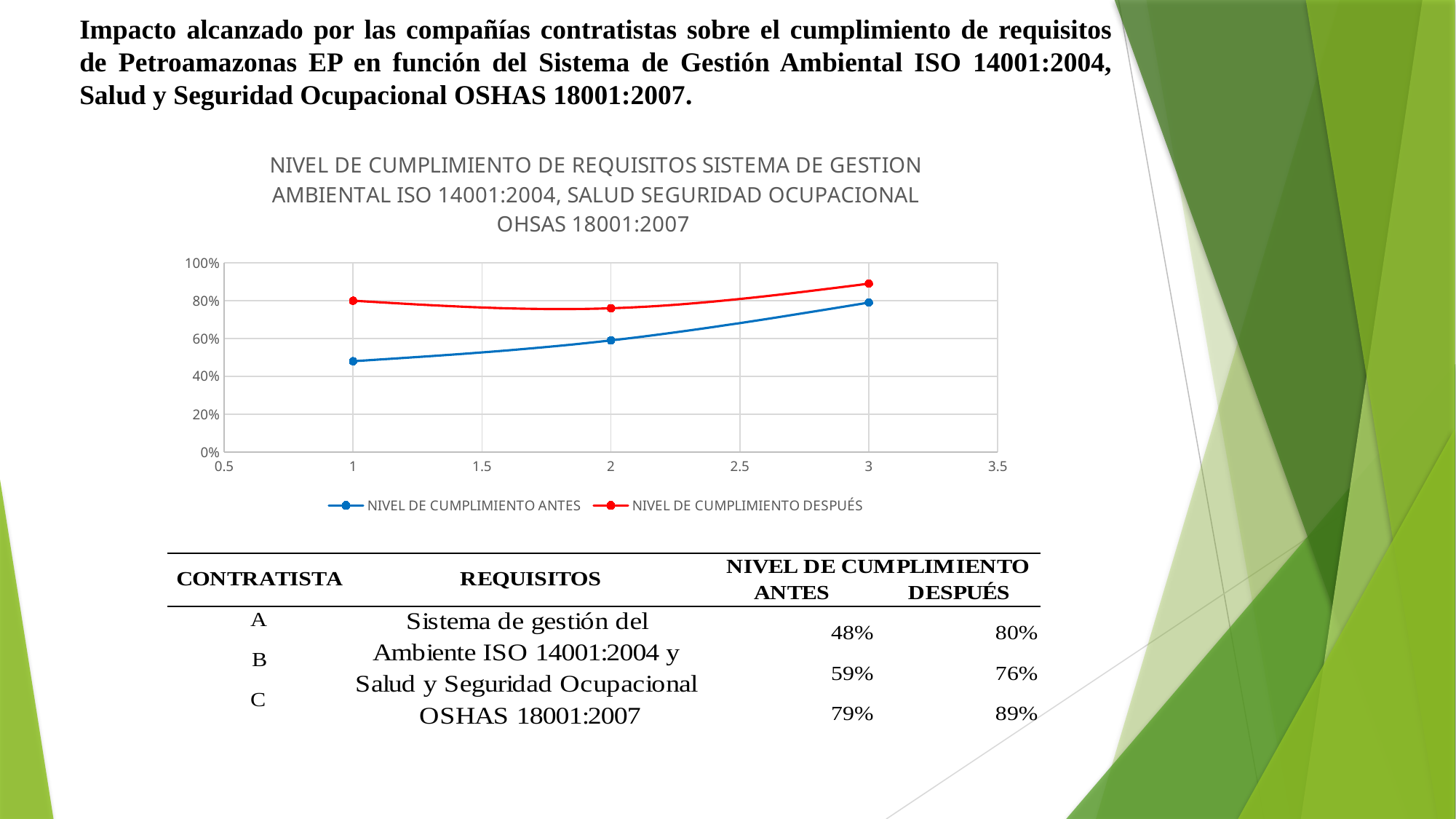
How many data points does each line in the chart have? 3 What kind of chart is shown on the slide? line chart Which series is plotted in red in the chart? NIVEL DE CUMPLIMIENTO DESPUÉS According to the table below the chart, what is the NIVEL DE CUMPLIMIENTO ANTES for contratista A? 48% At which x value does the NIVEL DE CUMPLIMIENTO ANTES line reach its highest point? 3 According to the table below the chart, what is the difference between the DESPUÉS and ANTES values for contratista B? 17% At which x value does the NIVEL DE CUMPLIMIENTO DESPUÉS line reach its lowest point? 2 Does the NIVEL DE CUMPLIMIENTO ANTES line rise or fall from x = 1 to x = 3? rise How many series does the chart legend list? 2 At x = 2, which series has the larger value, NIVEL DE CUMPLIMIENTO ANTES or NIVEL DE CUMPLIMIENTO DESPUÉS? NIVEL DE CUMPLIMIENTO DESPUÉS Is the value of NIVEL DE CUMPLIMIENTO DESPUÉS at x = 3 greater or less than 80%? greater Is the value of NIVEL DE CUMPLIMIENTO ANTES at x = 1 greater or less than 60%? less